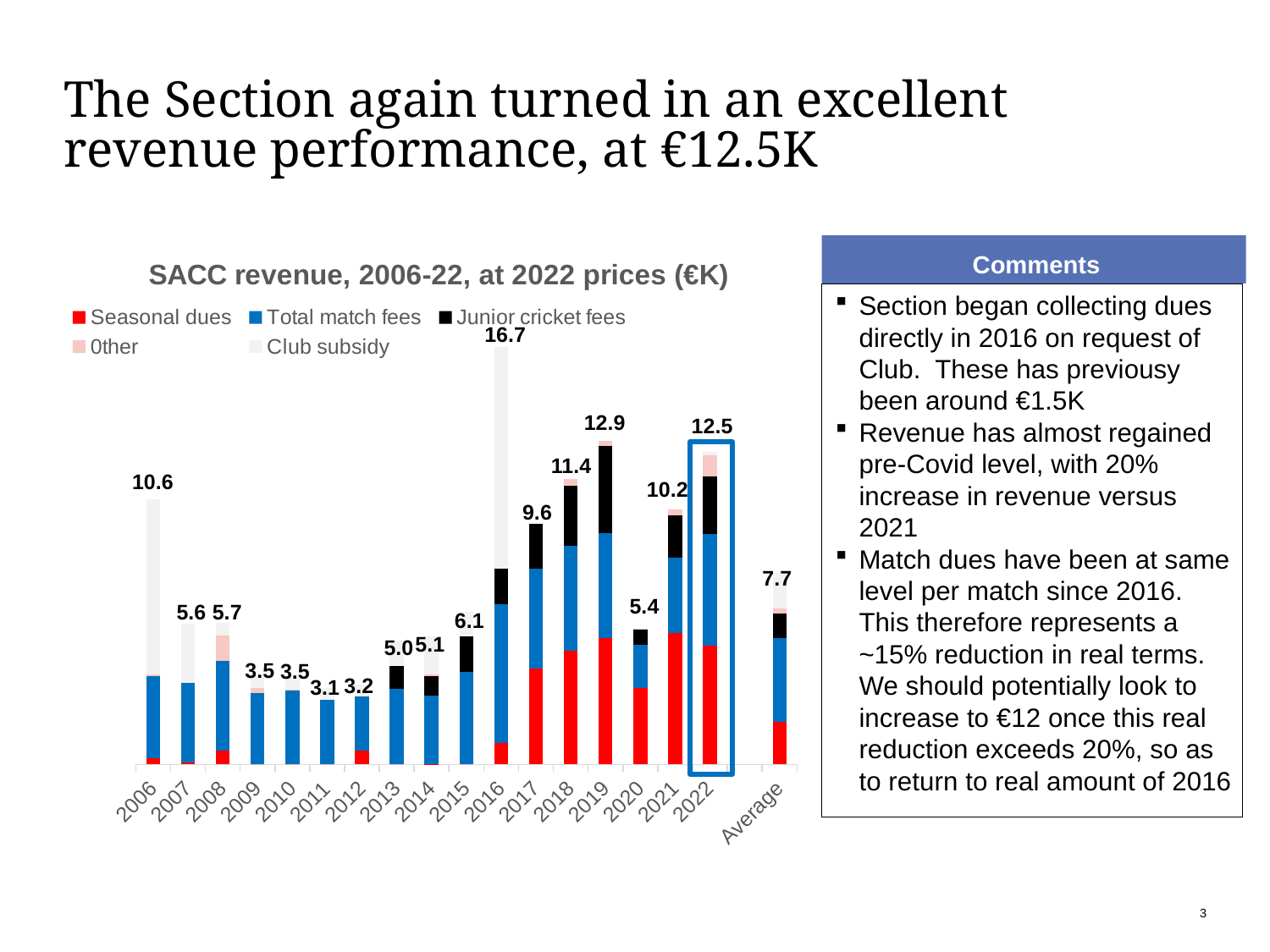
What is the total revenue shown for 2016? 16.7 What kind of chart is shown on the slide? Stacked bar chart What is the title of the chart? SACC revenue, 2006-22, at 2022 prices (€K) What is the total revenue shown for 2022? 12.5 What is the difference between the total revenue for 2022 and 2021? 2.3 Do the total revenue values rise or fall from 2017 to 2019? Rise Which year has the lowest total revenue? 2011 Which year has the highest total revenue? 2016 What is the value labelled for the Average bar? 7.7 Which year has the larger total revenue, 2019 or 2018? 2019 How many series does the legend list? 5 How many bars are plotted in the chart, including the Average bar? 18